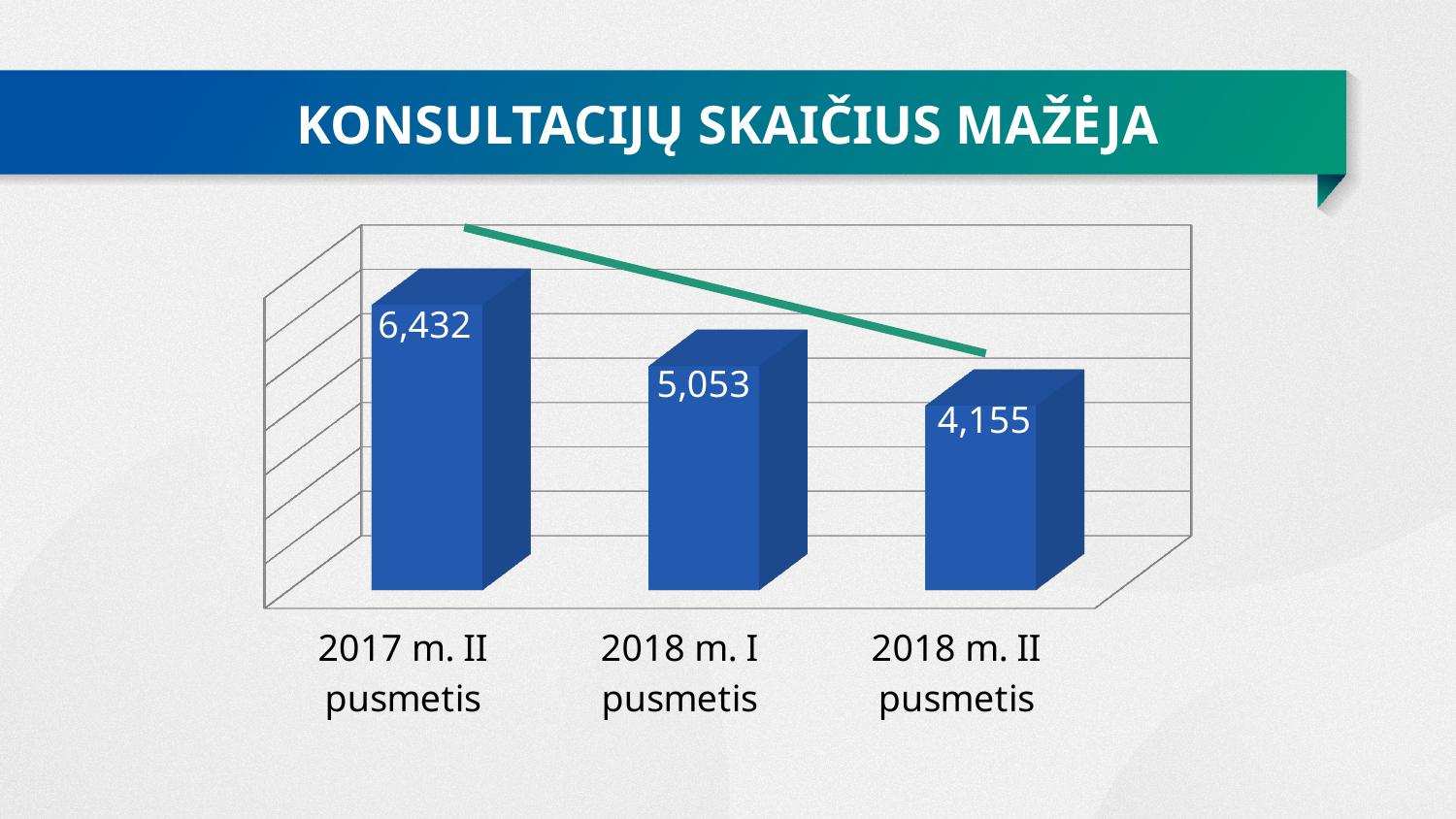
What kind of chart is shown on the slide? bar chart Which is larger, the value for 2018 m. I pusmetis or 2018 m. II pusmetis? 2018 m. I pusmetis What is the difference between the values for 2017 m. II pusmetis and 2018 m. II pusmetis? 2,277 What is the difference between the values for 2018 m. I pusmetis and 2018 m. II pusmetis? 898 What is the value for 2018 m. II pusmetis? 4,155 What is the title of the slide? KONSULTACIJŲ SKAIČIUS MAŽĖJA How many categories are shown in the chart? 3 What is the value for 2017 m. II pusmetis? 6,432 Which category has the highest value? 2017 m. II pusmetis Do the values rise or fall from left to right along the x axis? fall Which category has the lowest value? 2018 m. II pusmetis What is the value for 2018 m. I pusmetis? 5,053